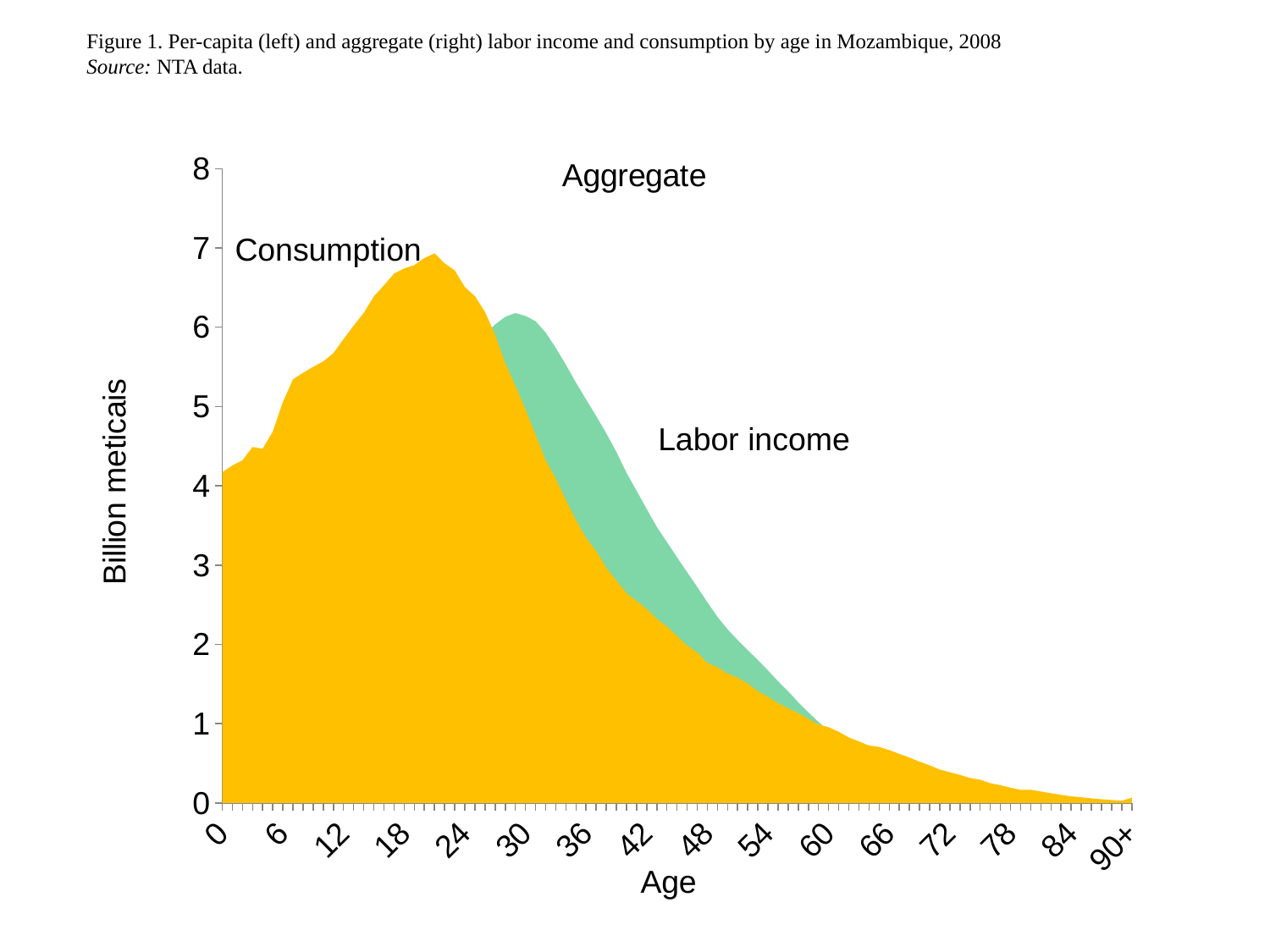
Is the peak value of Labor income greater or less than 6? greater Does Consumption rise or fall as age increases from 24 to 90+? Fall What kind of chart is shown on the slide? Area chart Which series reaches the higher peak value, Consumption or Labor income? Consumption Is the value of Consumption at age 0 greater or less than 4? greater Is the value of Consumption at age 84 greater or less than 1? less What is the label on the vertical axis of the chart? Billion meticais What is the title printed above the chart? Aggregate At age 36, which is larger: Labor income or Consumption? Labor income